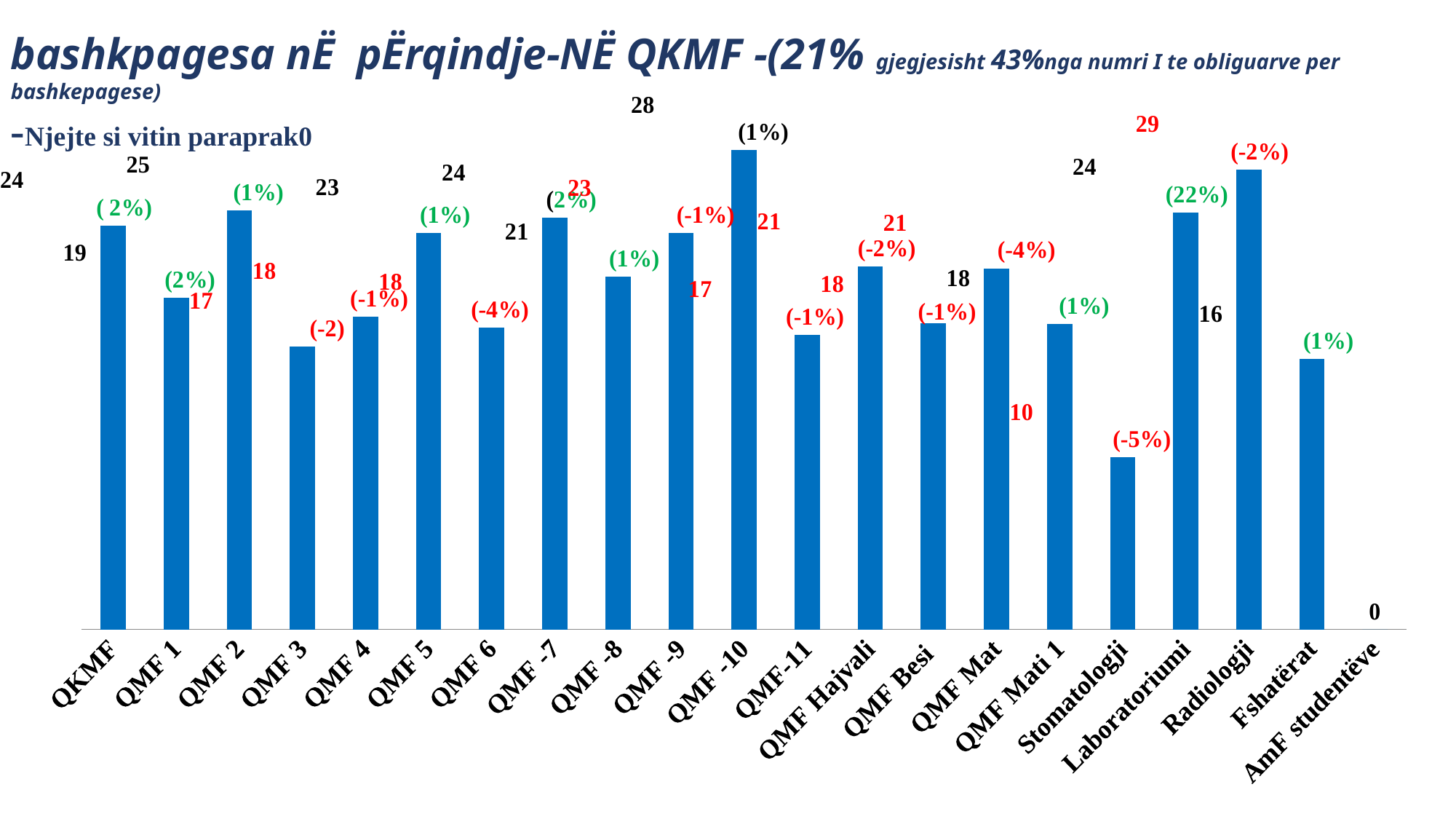
Which category has the tallest bar in the chart? QMF -10 What is the value shown for AmF studentëve? 0 Which has the larger value, Radiologji or QMF Mat? Radiologji Which has the larger value, QMF 2 or QMF 3? QMF 2 What percentage is given in parentheses right after 'QKMF' in the slide title? 21% Which has the larger value, Laboratoriumi or QMF Hajvali? Laboratoriumi What kind of chart is shown on the slide? bar chart What colour are the bars in the chart? blue Which category has the lowest value in the chart? AmF studentëve How many categories are shown along the x axis of the chart? 21 Among the categories that have a visible bar, which one has the shortest bar? Stomatologji